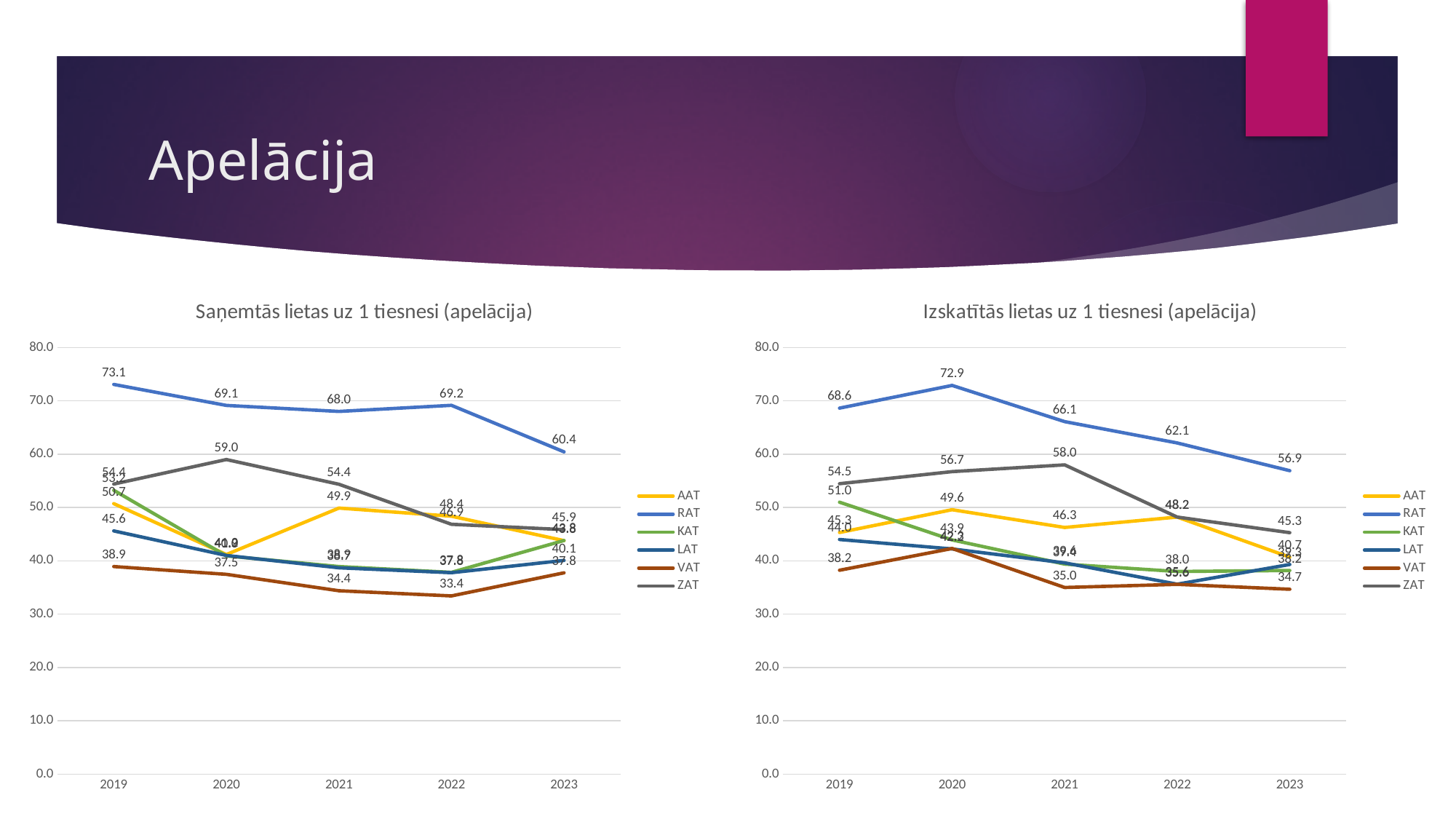
How many series does the legend of the left chart, "Saņemtās lietas uz 1 tiesnesi (apelācija)", list? 6 In the right chart, "Izskatītās lietas uz 1 tiesnesi (apelācija)", what is the difference between the RAT values for 2020 and 2023? 16.0 In the right chart, "Izskatītās lietas uz 1 tiesnesi (apelācija)", does the RAT line rise or fall from 2020 to 2023? fall What kind of chart is the left chart, "Saņemtās lietas uz 1 tiesnesi (apelācija)"? line chart In the right chart, "Izskatītās lietas uz 1 tiesnesi (apelācija)", which is larger in 2019: RAT or ZAT? RAT In the right chart, "Izskatītās lietas uz 1 tiesnesi (apelācija)", what is the value for ZAT in 2021? 58.0 In the chart titled "Saņemtās lietas uz 1 tiesnesi (apelācija)", what is the value for RAT in 2019? 73.1 How many years are shown on the x axis of the right chart, "Izskatītās lietas uz 1 tiesnesi (apelācija)"? 5 In the left chart, "Saņemtās lietas uz 1 tiesnesi (apelācija)", what is the difference between the RAT values for 2019 and 2023? 12.7 In the left chart, "Saņemtās lietas uz 1 tiesnesi (apelācija)", what is the value for VAT in 2022? 33.4 In the right chart, "Izskatītās lietas uz 1 tiesnesi (apelācija)", what is the value for RAT in 2020? 72.9 In the left chart, "Saņemtās lietas uz 1 tiesnesi (apelācija)", in which year is the RAT value highest? 2019